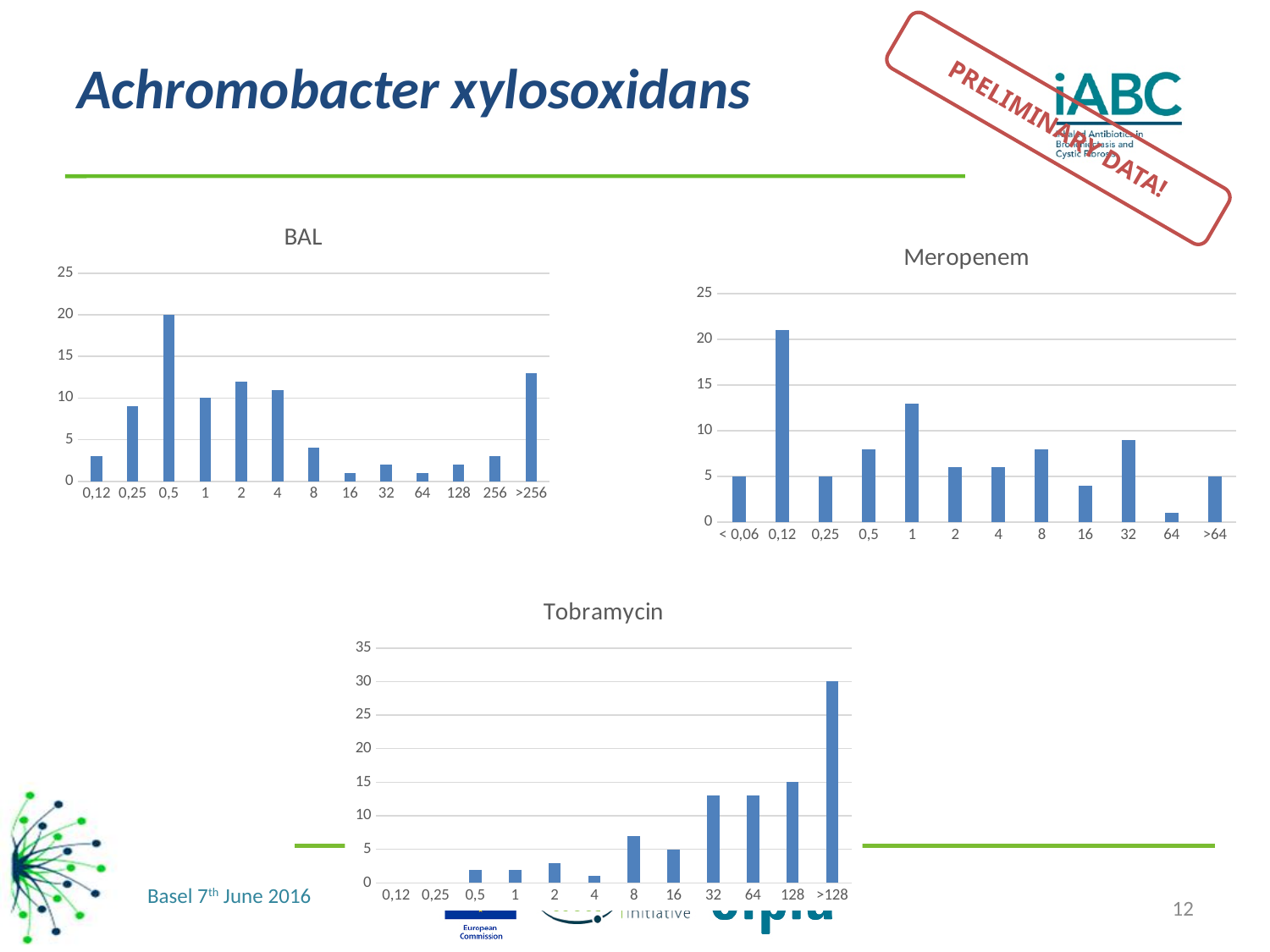
On the Tobramycin chart, what is the difference between the values for >128 and 128? 15 On the Tobramycin chart, what is the value for the >128 category? 30 On the BAL chart, how many categories are shown on the x axis? 13 On the BAL chart, what is the difference between the values for 0,5 and 1? 10 On the Meropenem chart, which category has the highest value? 0,12 On the Meropenem chart, which has the larger value, 1 or 32? 1 On the BAL chart, what is the value for the 0,5 category? 20 On the Meropenem chart, how many categories are shown on the x axis? 12 On the Meropenem chart, is the value for 0,12 greater or less than 20? greater What kind of chart is the Tobramycin chart? Bar chart On the BAL chart, what is the value for the 1 category? 10 On the BAL chart, which category has the highest value? 0,5